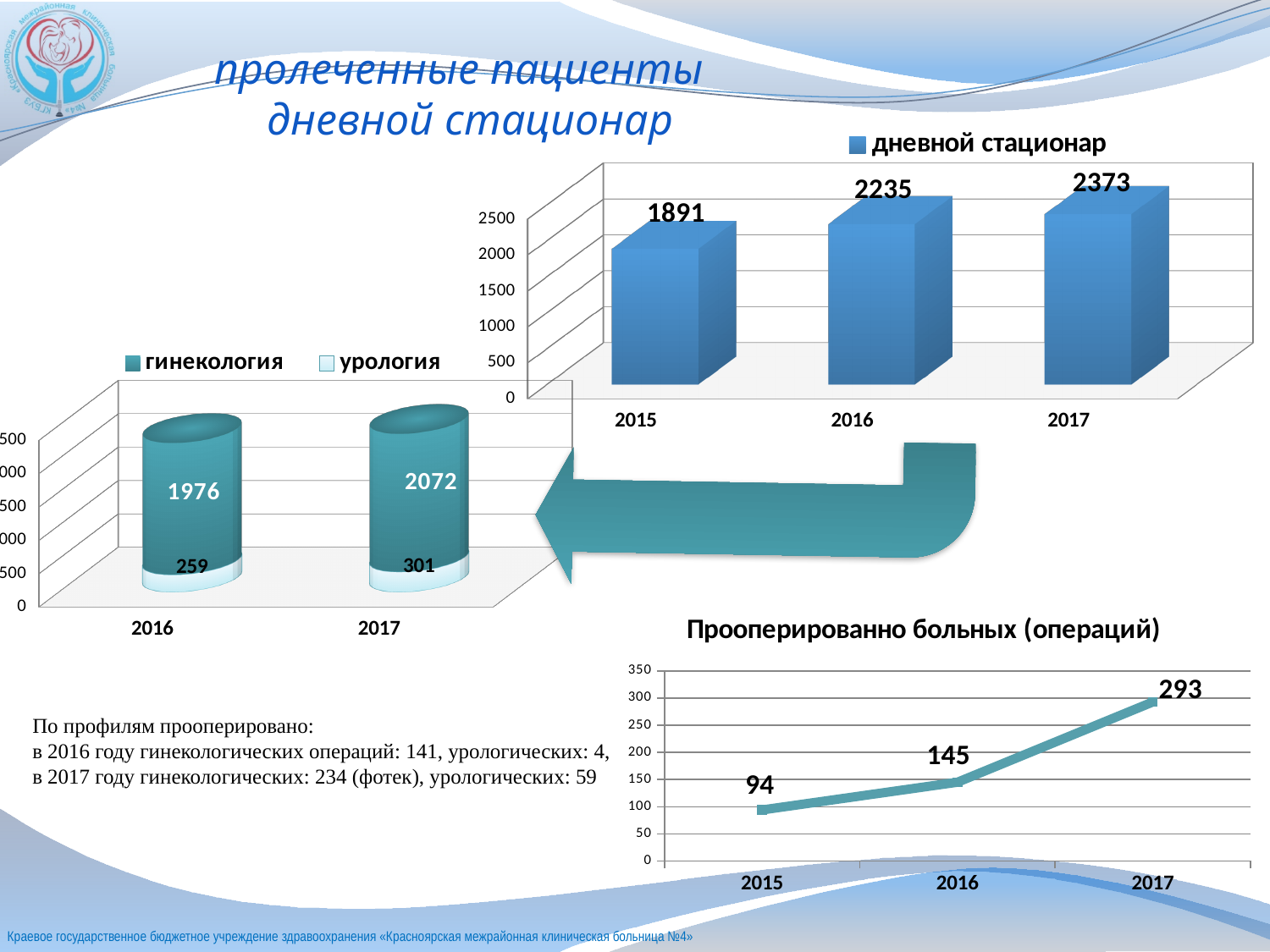
In the 'Прооперированно больных (операций)' chart, what is the value for 2015? 94 In the 'дневной стационар' bar chart, what is the value for 2016? 2235 How many years are plotted in the 'Прооперированно больных (операций)' chart? 3 In the stacked chart with the 'гинекология' and 'урология' legend, what is the 'урология' value for 2017? 301 In the 'Прооперированно больных (операций)' chart, what is the difference between the 2017 and 2016 values? 148 In the stacked chart with the 'гинекология' and 'урология' legend, what is the 'гинекология' value for 2016? 1976 In the 'дневной стационар' bar chart, which year has the highest value? 2017 How many series does the legend of the stacked chart on the left list? 2 In the 'дневной стационар' bar chart, do the values rise or fall from 2015 to 2017? rise In the stacked chart with the 'гинекология' and 'урология' legend, what is the total of the 2017 bar? 2373 What kind of chart is 'Прооперированно больных (операций)'? line chart In the 'дневной стационар' bar chart, what is the difference between the 2017 and 2015 values? 482